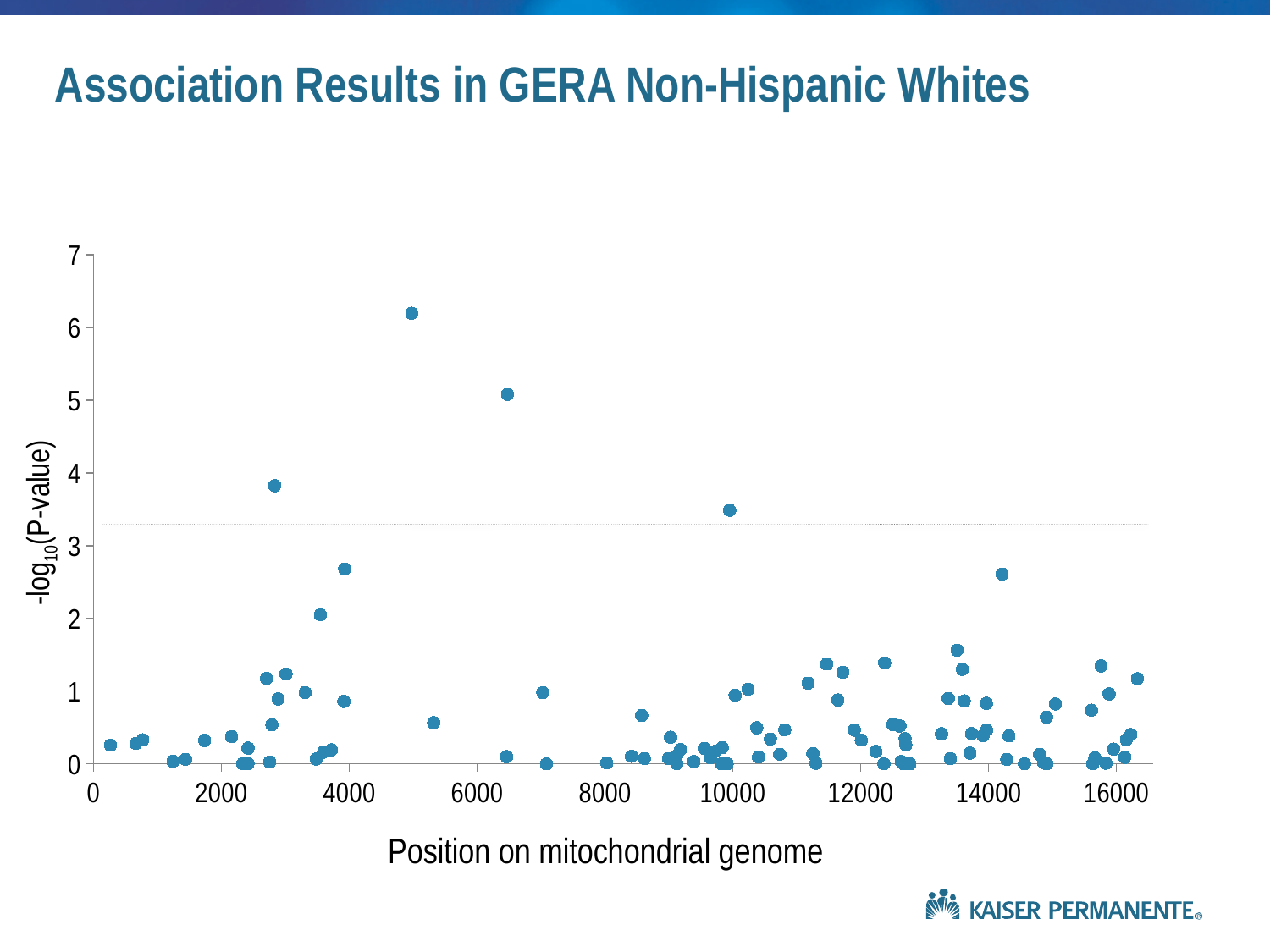
Is the value of the point near position 10000 that lies above the dashed line greater or less than 3? greater Is the value of the highest point on the chart greater or less than 6? greater What is the title of the chart? Association Results in GERA Non-Hispanic Whites What is the label of the x axis? Position on mitochondrial genome Is the value of the highest point near position 14200 greater or less than 3? less How many points have a -log10(P-value) greater than 6? 1 How many points lie above the horizontal dashed line? 4 What kind of chart is shown on the slide? scatter chart